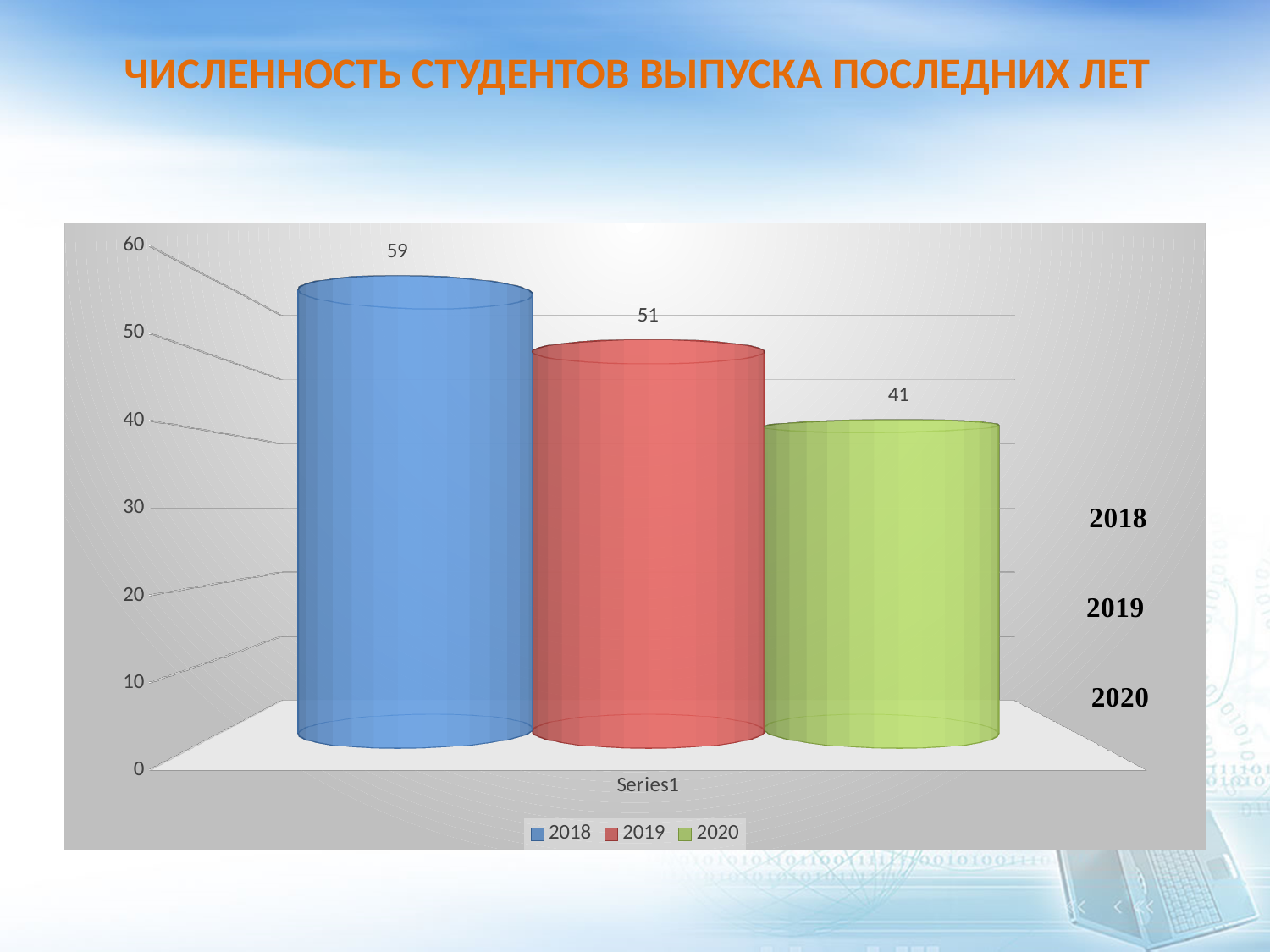
What is the difference between the values for 2018 and 2019? 8 Do the values rise or fall from 2018 to 2020? fall What kind of chart is shown on the slide? bar chart Which year has the highest value? 2018 How many series does the legend list? 3 Which year has the lowest value? 2020 What is the value for 2020? 41 What is the value for 2019? 51 Which is larger, the value for 2019 or the value for 2020? 2019 What is the value for 2018? 59 What colour is the bar for 2019? red What is the difference between the values for 2018 and 2020? 18